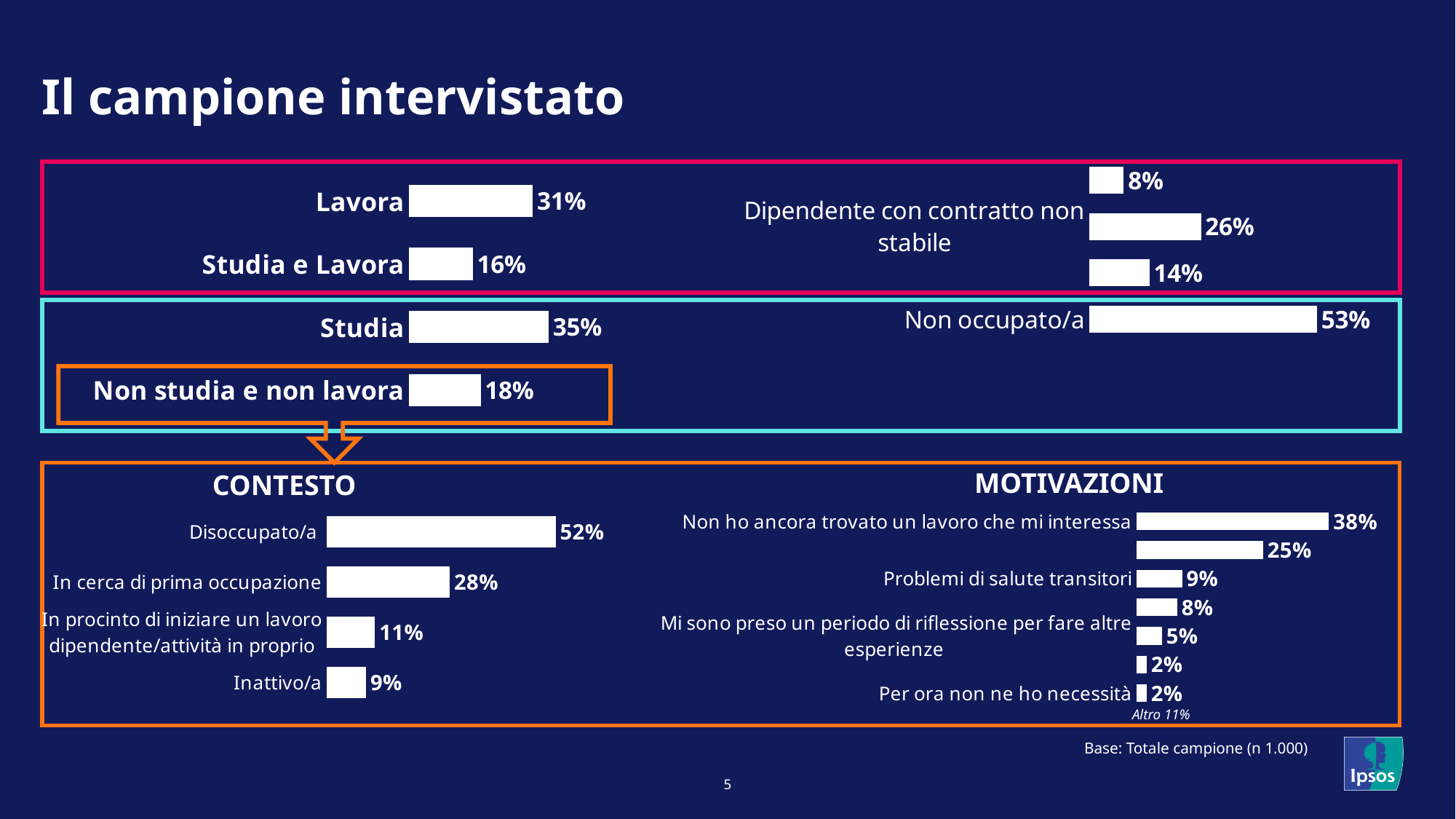
In the CONTESTO chart, what is the value for "In cerca di prima occupazione"? 28% In the top-left chart of employment/study status, what is the difference between "Lavora" and "Studia e Lavora"? 15% In the MOTIVAZIONI chart, what is the value for "Non ho ancora trovato un lavoro che mi interessa"? 38% In the MOTIVAZIONI chart, which is larger: "Problemi di salute transitori" or "Per ora non ne ho necessità"? Problemi di salute transitori In the CONTESTO chart, how many categories are shown? 4 In the CONTESTO chart, which category has the highest value? Disoccupato/a In the top-right chart, what is the value for "Non occupato/a"? 53% In the top-left chart of employment/study status, which category has the lowest value? Studia e Lavora In the top-left chart of employment/study status, what is the value for "Non studia e non lavora"? 18% In the top-right chart, what is the value for "Dipendente con contratto non stabile"? 26% In the top-left chart of employment/study status, what is the value for "Studia"? 35% In the top-left chart of employment/study status, which category has the highest value? Studia